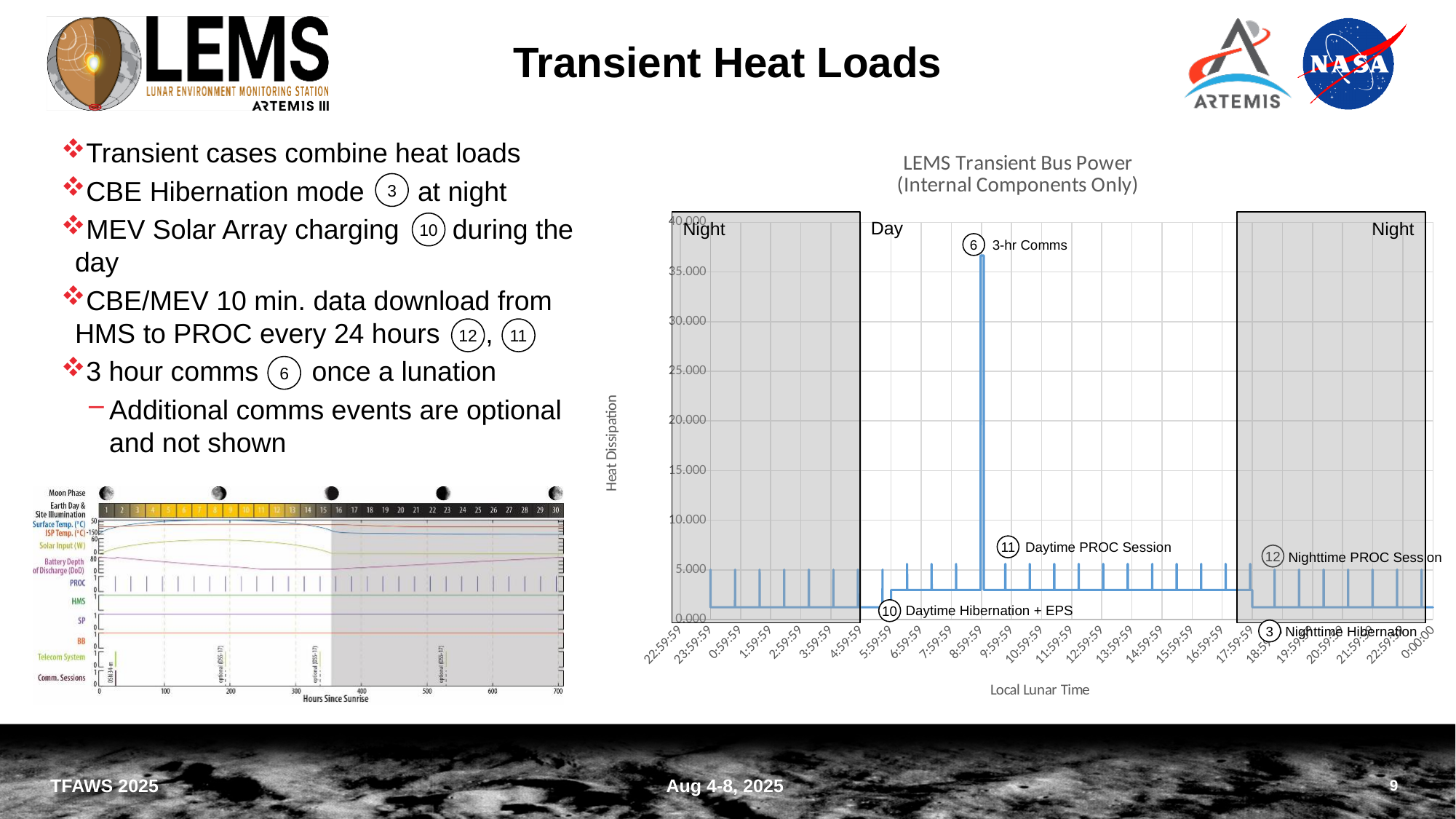
In the LEMS Transient Bus Power chart, is the Nighttime Hibernation level greater or less than 5.000? less What is the title of the chart on the right side of the slide? LEMS Transient Bus Power (Internal Components Only) In the LEMS Transient Bus Power chart, which annotated event has the highest heat dissipation? 3-hr Comms What is the x-axis label of the LEMS Transient Bus Power chart? Local Lunar Time What kind of chart is the 'LEMS Transient Bus Power' chart? line chart In the LEMS Transient Bus Power chart, is the Daytime Hibernation + EPS level greater or less than 5.000? less In the LEMS Transient Bus Power chart, which is higher: the Daytime Hibernation + EPS level or the Nighttime Hibernation level? Daytime Hibernation + EPS In the LEMS Transient Bus Power chart, is the 3-hr Comms peak greater or less than 10.000? greater In the LEMS Transient Bus Power chart, which annotated event has the lowest heat dissipation level? Nighttime Hibernation What is the highest tick value shown on the y-axis of the LEMS Transient Bus Power chart? 40.000 How many numbered event annotations are shown on the LEMS Transient Bus Power chart? 5